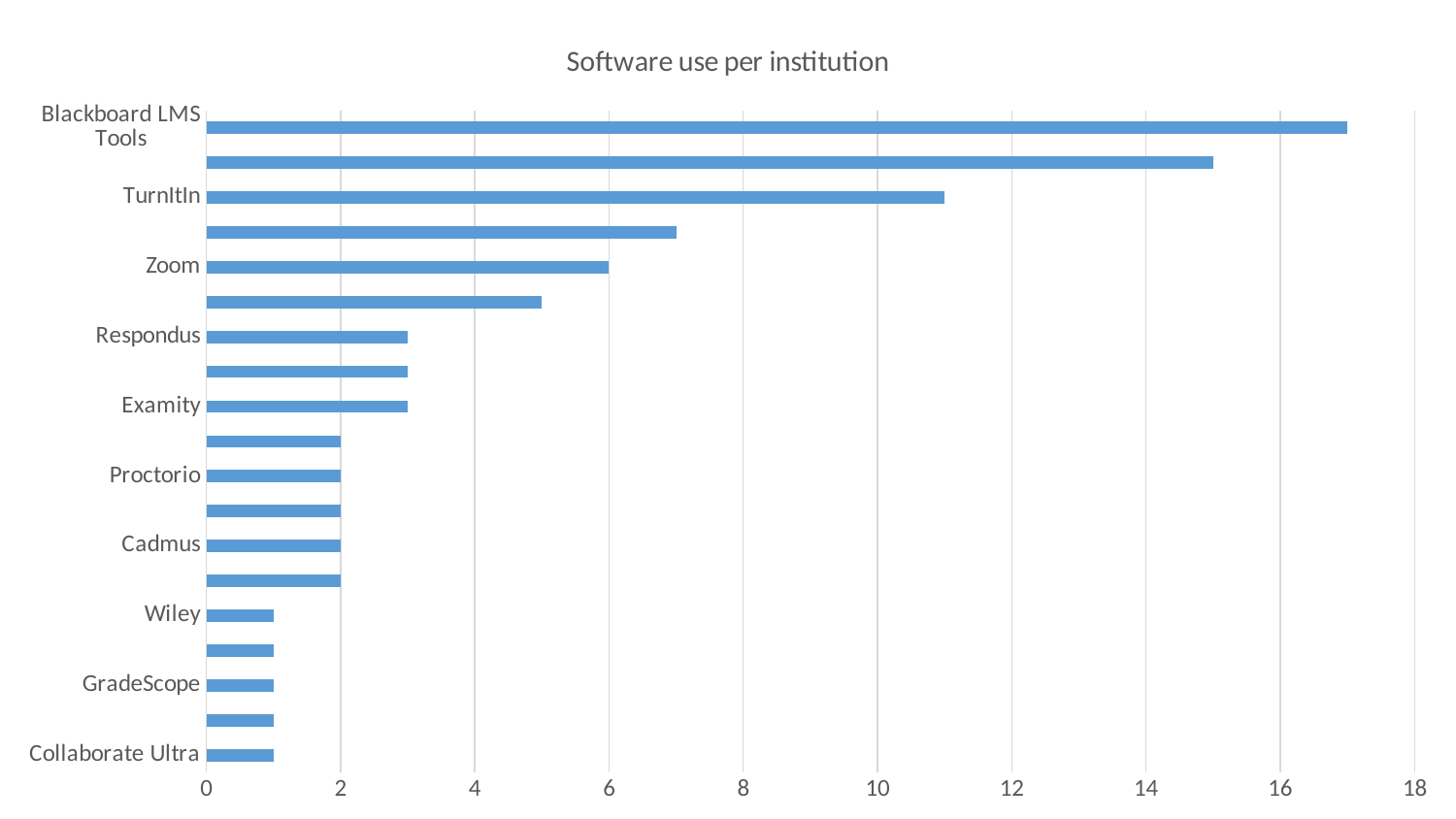
What is the value for Cadmus? 2 Which software has the highest value in the chart? Blackboard LMS Tools What kind of chart is shown on the slide? bar chart What is the difference between the values for Zoom and Proctorio? 4 What is the value for Zoom? 6 What is the title of the chart? Software use per institution Is the value for Wiley greater or less than 2? less Is the value for Respondus greater or less than 4? less Is the value for Blackboard LMS Tools greater or less than 16? greater Which has a larger value, Blackboard LMS Tools or TurnItIn? Blackboard LMS Tools What is the value for Proctorio? 2